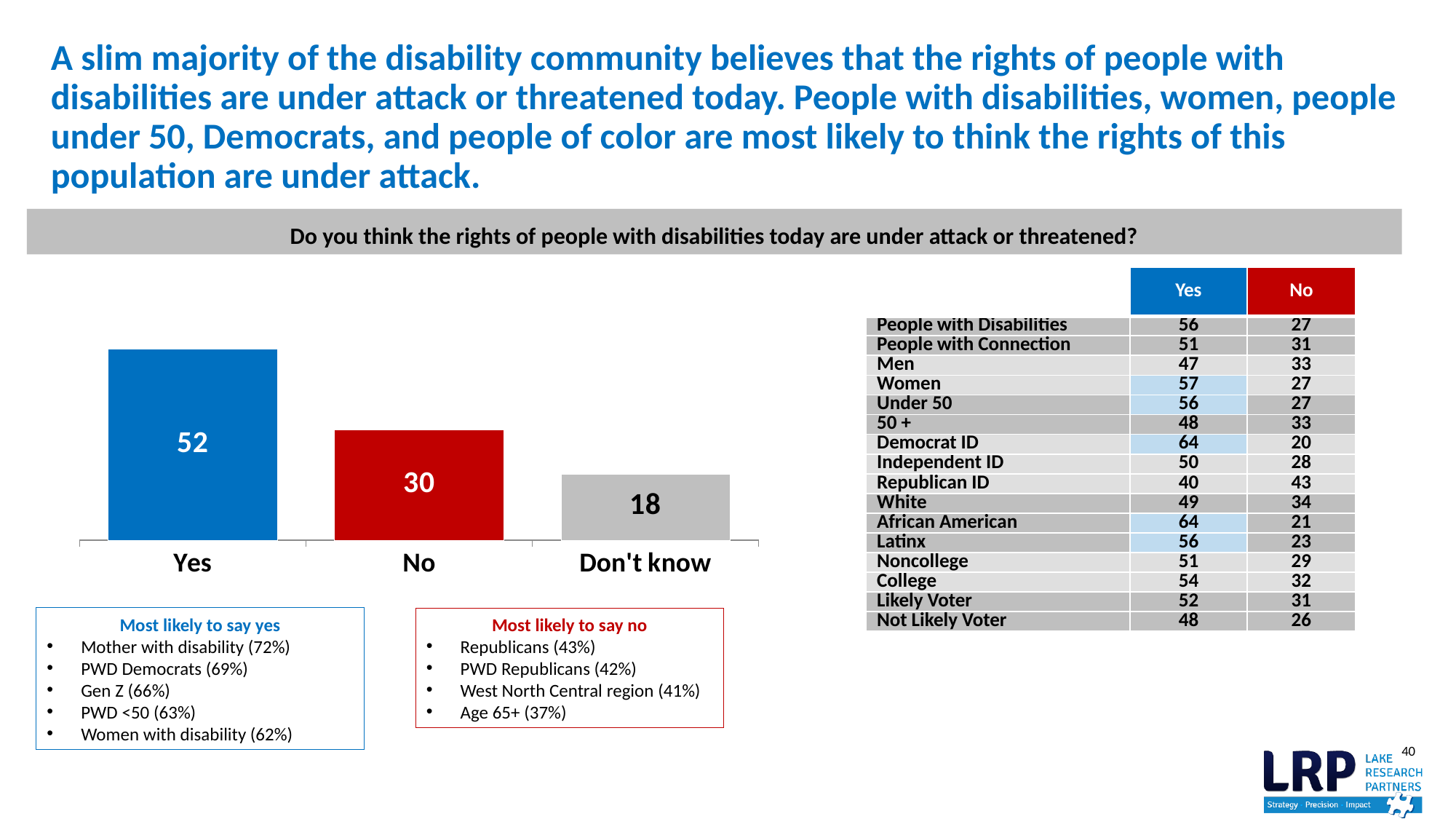
Do the values rise or fall moving from left to right across the chart? Fall What is the value of the "No" bar in the chart? 30 Which category has the highest value in the chart? Yes What kind of chart is shown on the slide? Bar chart What is the difference between the "Yes" and "No" values in the chart? 22 What is the difference between the "No" and "Don't know" values in the chart? 12 What colour is the "Yes" bar in the chart? Blue What is the value of the "Don't know" bar in the chart? 18 Which is larger in the chart, the value for "No" or the value for "Don't know"? No What is the value of the "Yes" bar in the chart? 52 Which category has the lowest value in the chart? Don't know How many categories are shown in the chart? 3